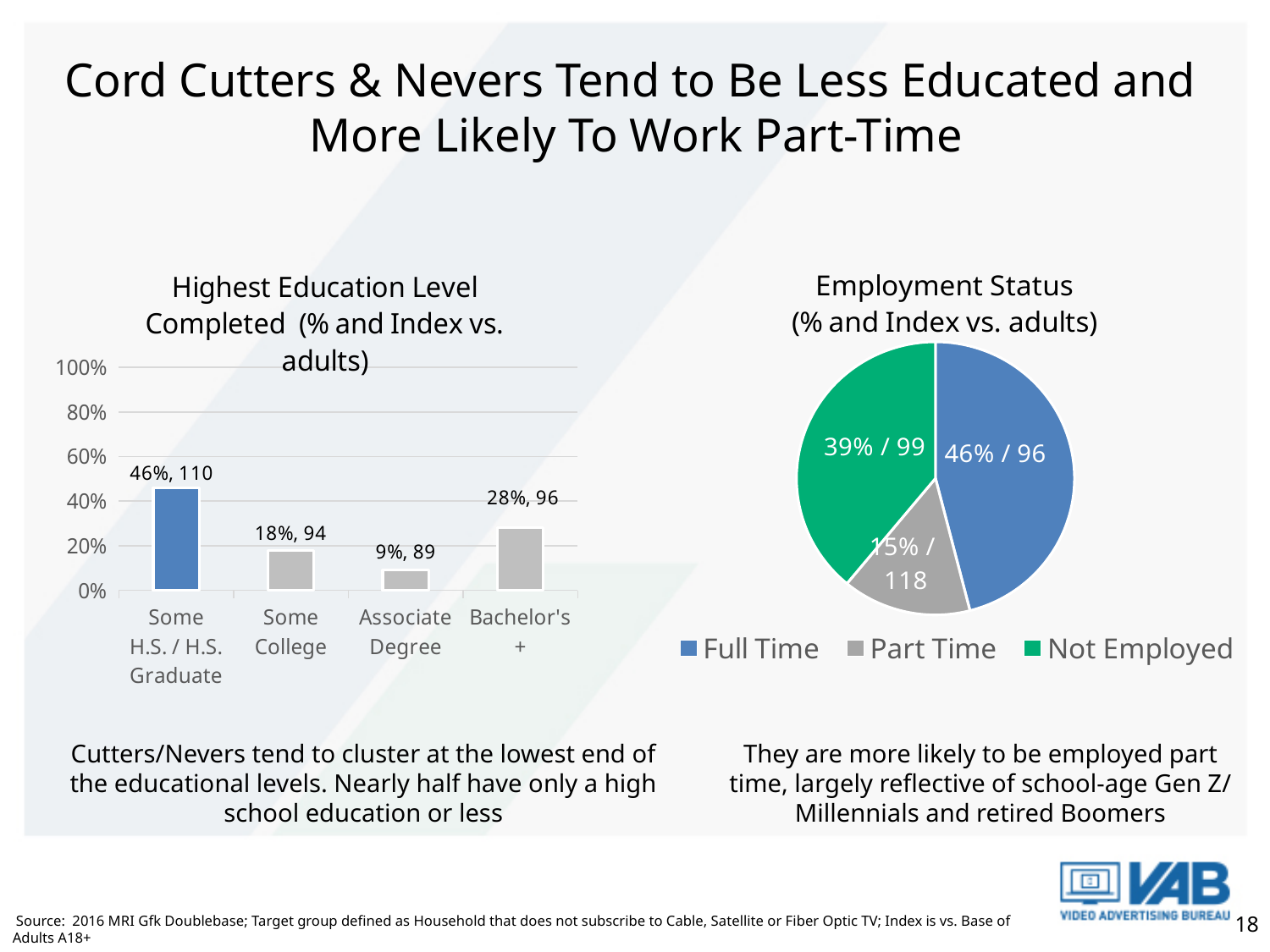
How many entries does the legend of the Employment Status chart list? 3 In the Highest Education Level Completed chart, how many education categories are shown? 4 In the Highest Education Level Completed chart, what percentage is shown for Bachelor's +? 28% In the Employment Status chart, what is the label on the Part Time slice? 15% / 118 In the Employment Status chart, which is larger, Full Time or Not Employed? Full Time What type of chart is the Highest Education Level Completed chart? Bar chart In the Employment Status chart, what colour is the Not Employed slice? Green In the Employment Status chart, what share of the pie is Not Employed? 39% In the Highest Education Level Completed chart, what is the difference in percentage points between Some H.S. / H.S. Graduate and Bachelor's +? 18 In the Highest Education Level Completed chart, what is the data label for Some H.S. / H.S. Graduate? 46%, 110 In the Highest Education Level Completed chart, which category has the highest percentage? Some H.S. / H.S. Graduate In the Highest Education Level Completed chart, which category has the lowest percentage? Associate Degree